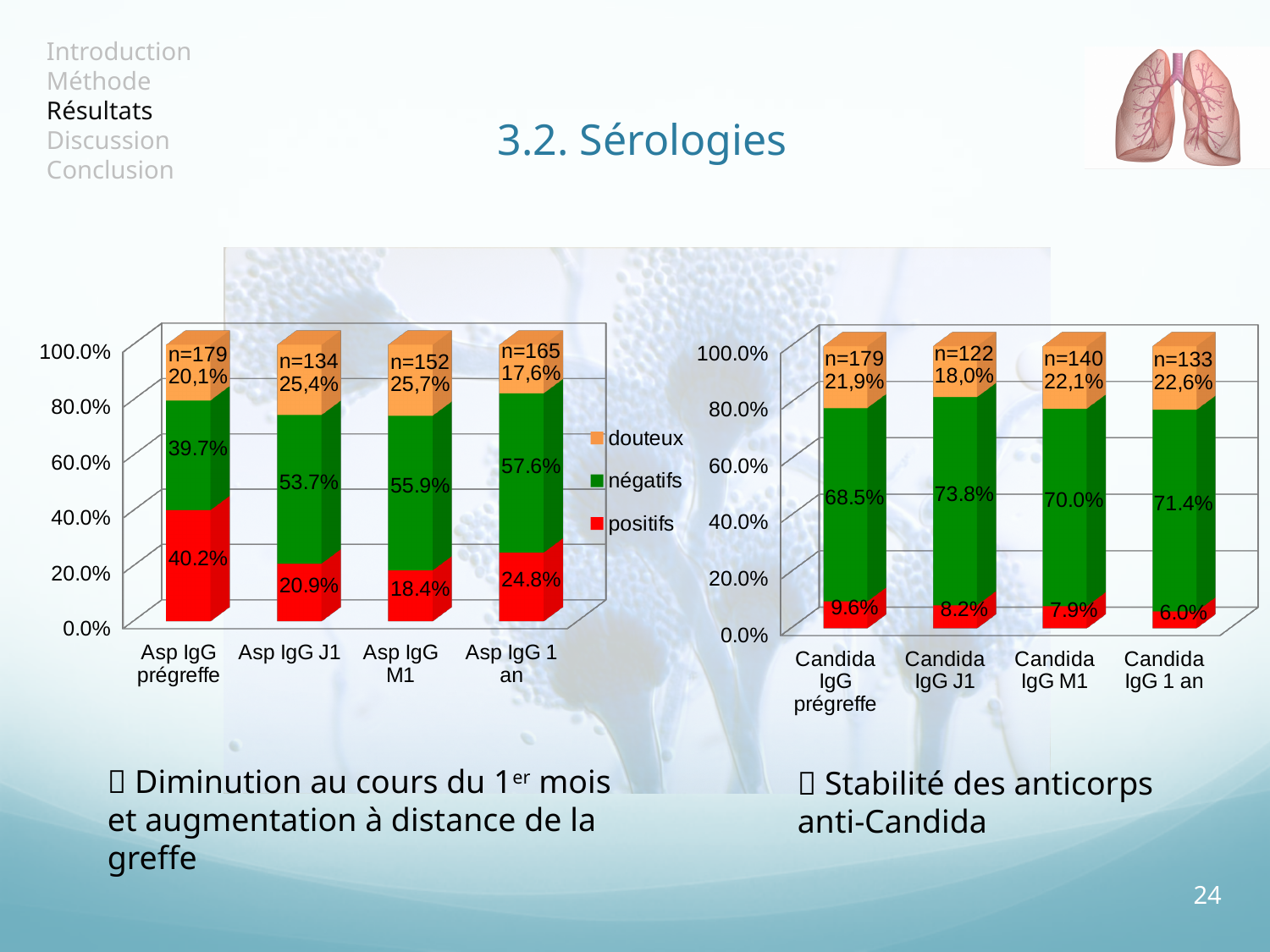
In the right chart (Candida IgG), what is the difference between the négatifs values for Candida IgG J1 and Candida IgG prégreffe? 5.3% In the right chart (Candida IgG), which category has the highest négatifs value? Candida IgG J1 In the right chart (Candida IgG), do the positifs values rise or fall from Candida IgG prégreffe to Candida IgG 1 an? fall In the right chart (Candida IgG), is the positifs value for Candida IgG prégreffe larger or smaller than the positifs value for Candida IgG M1? larger In the left chart (Asp IgG), what is the value of positifs for Asp IgG prégreffe? 40.2% What type of chart is the right chart (Candida IgG)? stacked bar chart In the left chart (Asp IgG), which category has the lowest positifs value? Asp IgG M1 In the left chart (Asp IgG), how many series does the legend list? 3 In the right chart (Candida IgG), what is the value of positifs for Candida IgG 1 an? 6.0% In the left chart (Asp IgG), how many categories are shown on the x axis? 4 In the left chart (Asp IgG), what is the value of négatifs for Asp IgG 1 an? 57.6% In the left chart (Asp IgG), what is the difference between the positifs values for Asp IgG prégreffe and Asp IgG J1? 19.3%